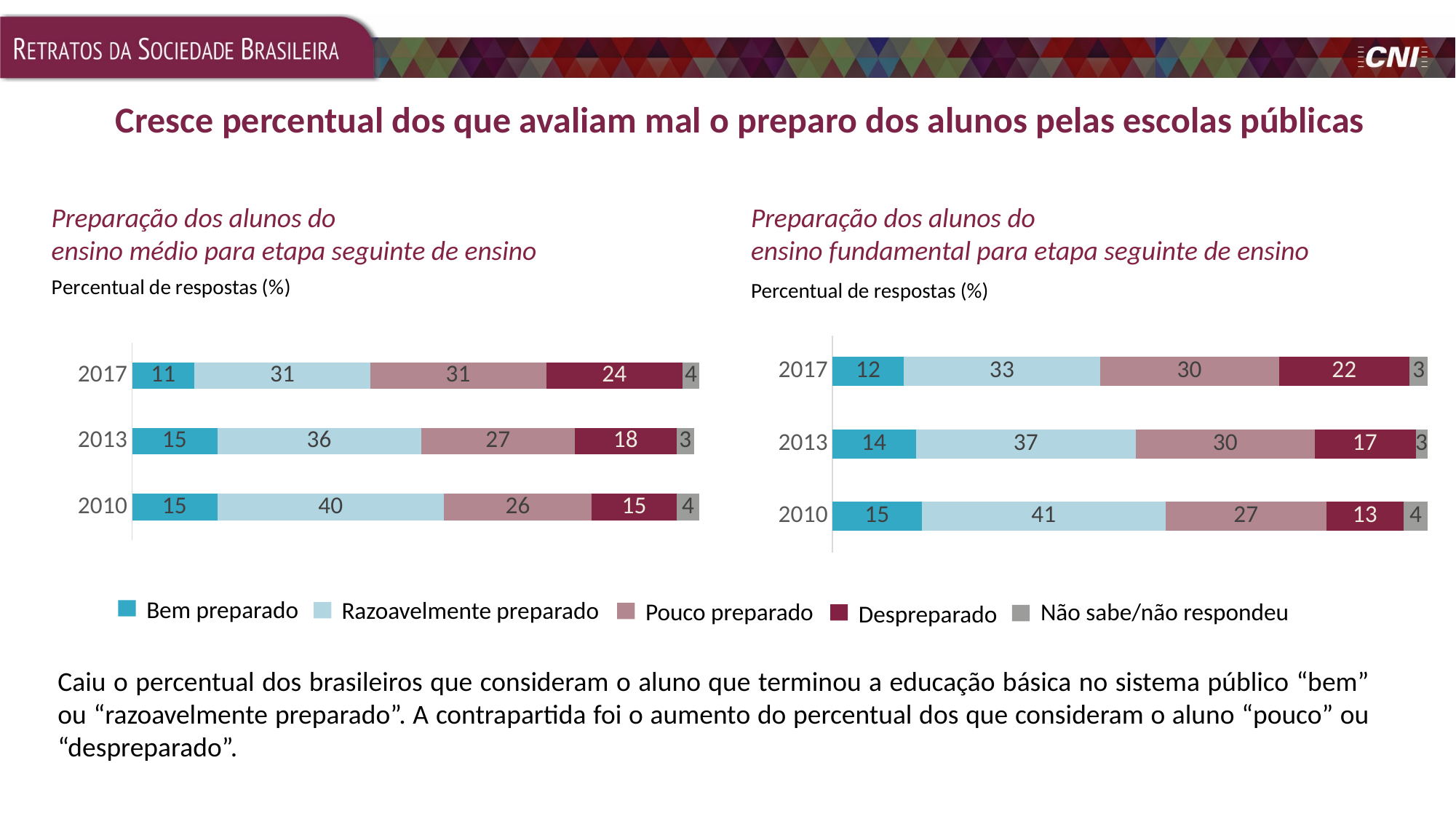
In the left chart (ensino médio), what is the value for "Bem preparado" in 2013? 15 How many series does the legend list? 5 In the left chart (ensino médio), what is the value for "Despreparado" in 2017? 24 In the right chart (ensino fundamental), which year has the lowest value for "Bem preparado"? 2017 In the right chart (ensino fundamental), what is the value for "Razoavelmente preparado" in 2010? 41 In the left chart (ensino médio), what is the difference between the "Razoavelmente preparado" values for 2010 and 2017? 9 In the right chart (ensino fundamental), which is larger: "Despreparado" in 2013 or "Despreparado" in 2010? 2013 In the right chart (ensino fundamental), does the "Despreparado" value rise or fall from 2010 to 2017? Rise In the left chart (ensino médio), which year has the highest value for "Despreparado"? 2017 What kind of chart is the right chart (ensino fundamental)? Stacked bar chart In the right chart (ensino fundamental), what is the value for "Pouco preparado" in 2017? 30 How many years are shown in the left chart (ensino médio)? 3